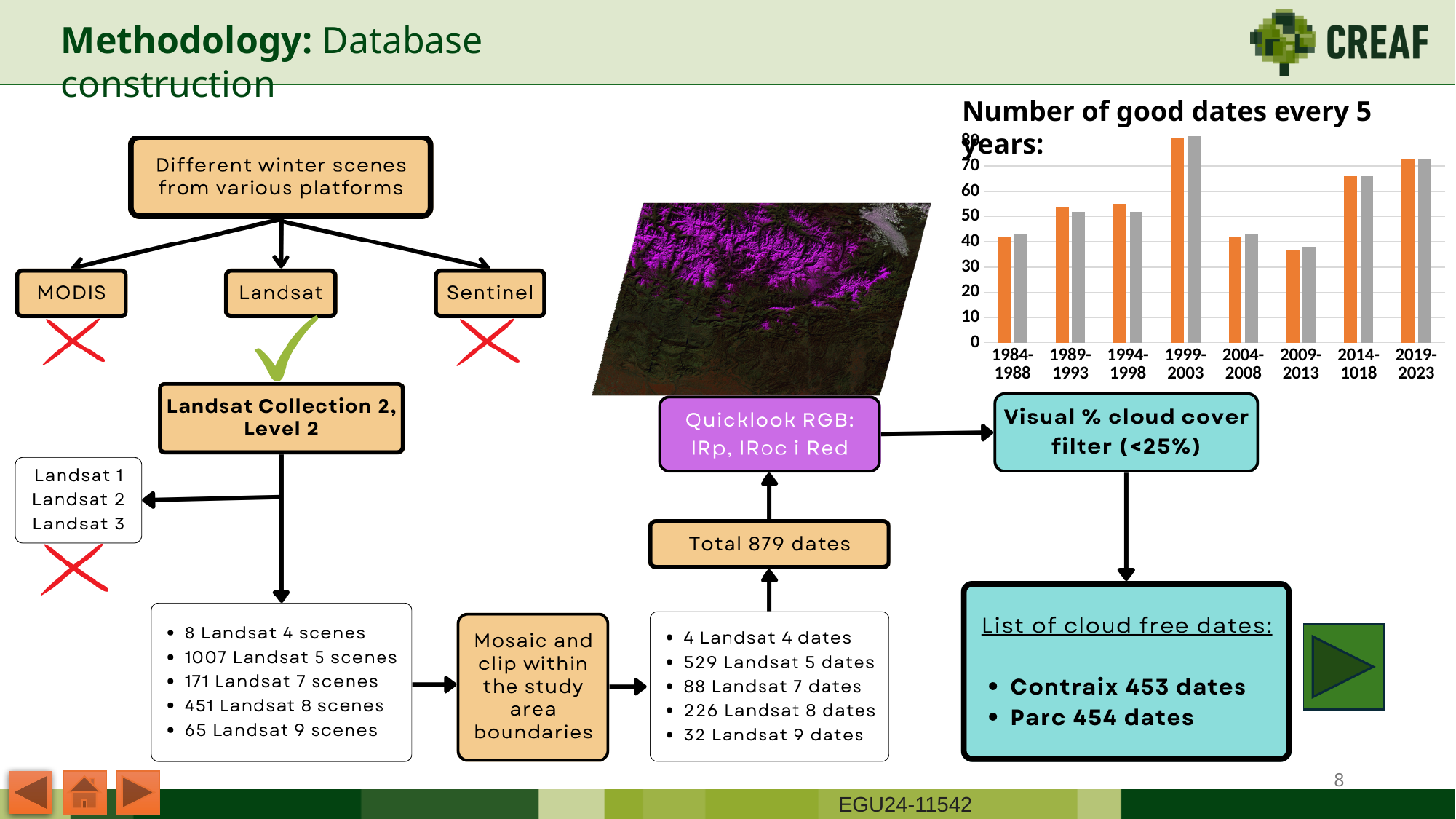
Is the orange bar for 2014-1018 greater or less than 60? greater How many bars are drawn for each 5-year period in the chart? 2 Which period has the larger orange bar, 2019-2023 or 2014-1018? 2019-2023 What kind of chart is shown under the title "Number of good dates every 5 years"? bar chart Is the orange bar for 1999-2003 greater or less than 70? greater What is the title of the bar chart on the slide? Number of good dates every 5 years: Which 5-year period has the highest number of good dates in the chart? 1999-2003 Which period has the larger orange bar, 1999-2003 or 2004-2008? 1999-2003 How many 5-year periods are shown on the x axis of the "Number of good dates every 5 years" chart? 8 Which 5-year period has the lowest number of good dates in the chart? 2009-2013 Is the orange bar for 2009-2013 greater or less than 40? less